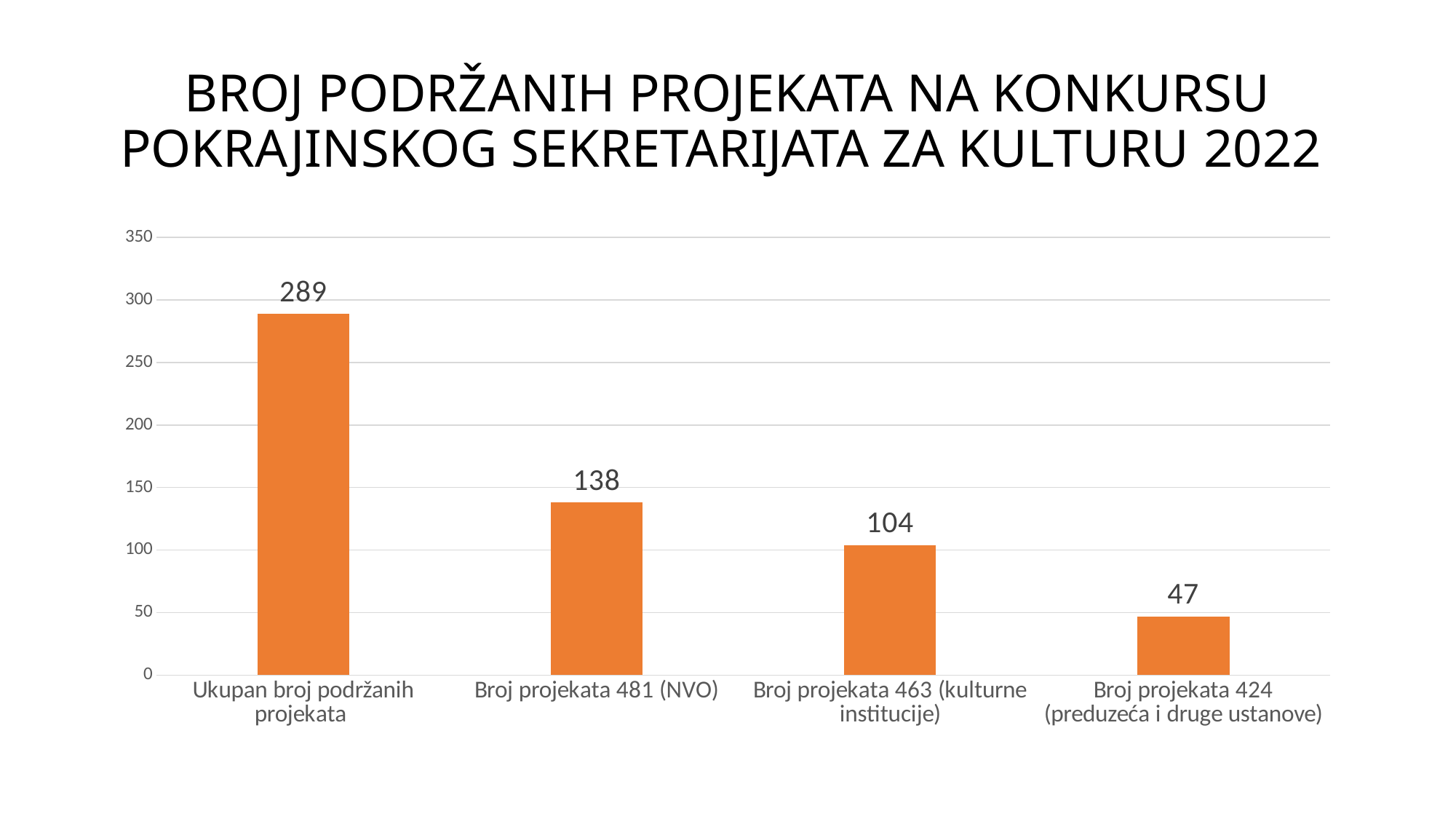
Which is larger: the value for "Broj projekata 481 (NVO)" or the value for "Broj projekata 463 (kulturne institucije)"? Broj projekata 481 (NVO) What kind of chart is shown on the slide? bar chart What is the value for "Broj projekata 424 (preduzeća i druge ustanove)"? 47 What is the value for "Ukupan broj podržanih projekata"? 289 What is the difference between the values for "Ukupan broj podržanih projekata" and "Broj projekata 424 (preduzeća i druge ustanove)"? 242 What is the difference between the values for "Broj projekata 481 (NVO)" and "Broj projekata 463 (kulturne institucije)"? 34 Is the value for "Broj projekata 424 (preduzeća i druge ustanove)" greater or less than 50? less What is the value for "Broj projekata 481 (NVO)"? 138 What is the value for "Broj projekata 463 (kulturne institucije)"? 104 How many categories are shown on the chart? 4 Which category has the lowest value? Broj projekata 424 (preduzeća i druge ustanove) Which category has the highest value? Ukupan broj podržanih projekata